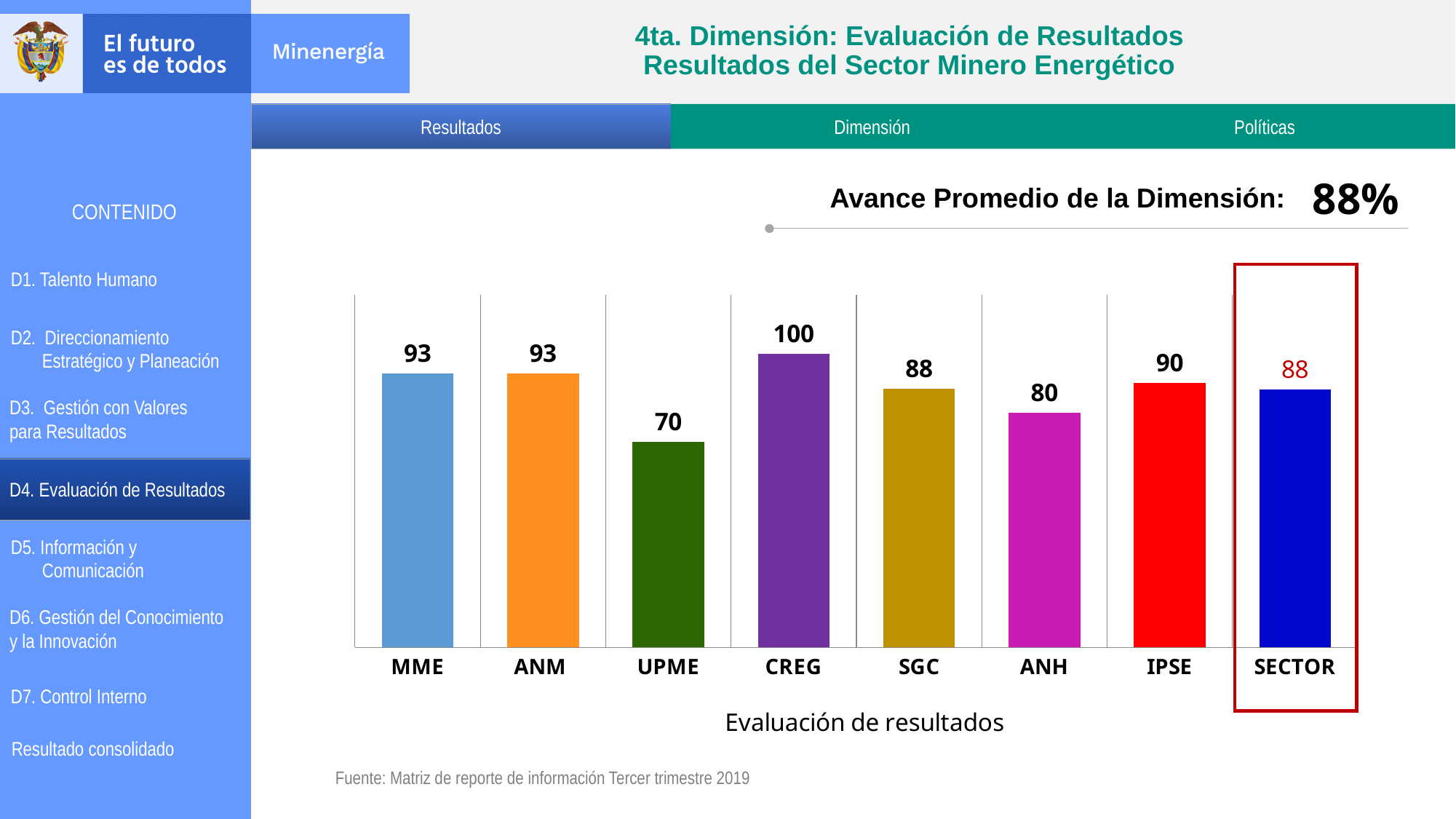
Which category has the highest value? CREG Which is larger, the value for SGC or the value for IPSE? IPSE What is the value for CREG? 100 What is the difference between the values for MME and UPME? 23 How many categories are shown on the x axis? 8 What is the value for IPSE? 90 Which category has the lowest value? UPME What is the difference between the values for CREG and ANH? 20 What is the x-axis title of the chart? Evaluación de resultados What is the value for UPME? 70 What kind of chart is shown on the slide? Bar chart What is the value for SECTOR? 88